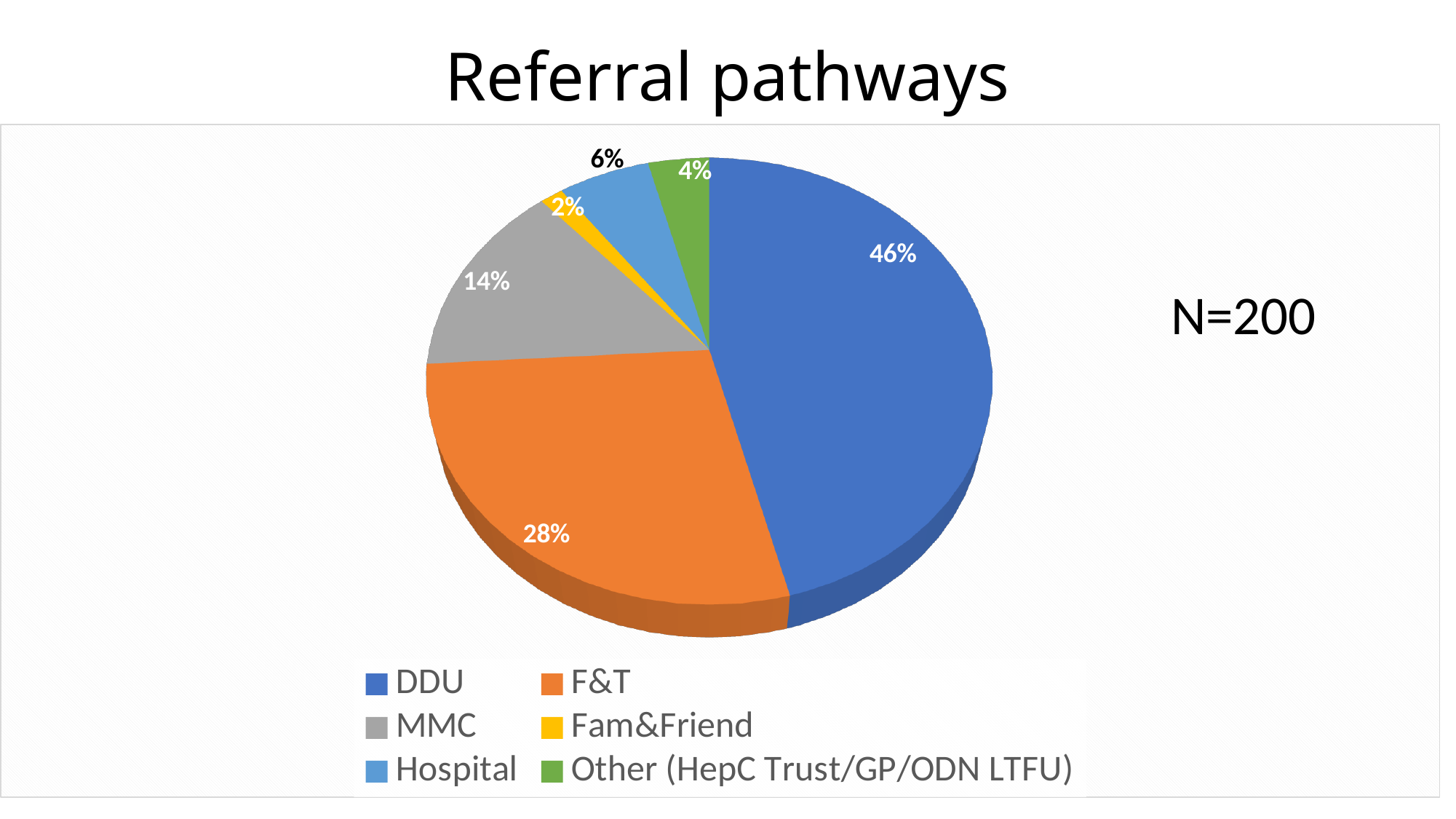
How many referral pathways are shown in the pie chart? 6 What kind of chart is shown on the slide? Pie chart What share of referrals came from Fam&Friend? 2% What is the difference in percentage points between the DDU and F&T shares? 18 Which has a larger share, Hospital or Other (HepC Trust/GP/ODN LTFU)? Hospital Which referral pathway has the largest share? DDU What share of referrals came from MMC? 14% What share of referrals came from F&T? 28% What is the title of the chart? Referral pathways Which referral pathway has the smallest share? Fam&Friend